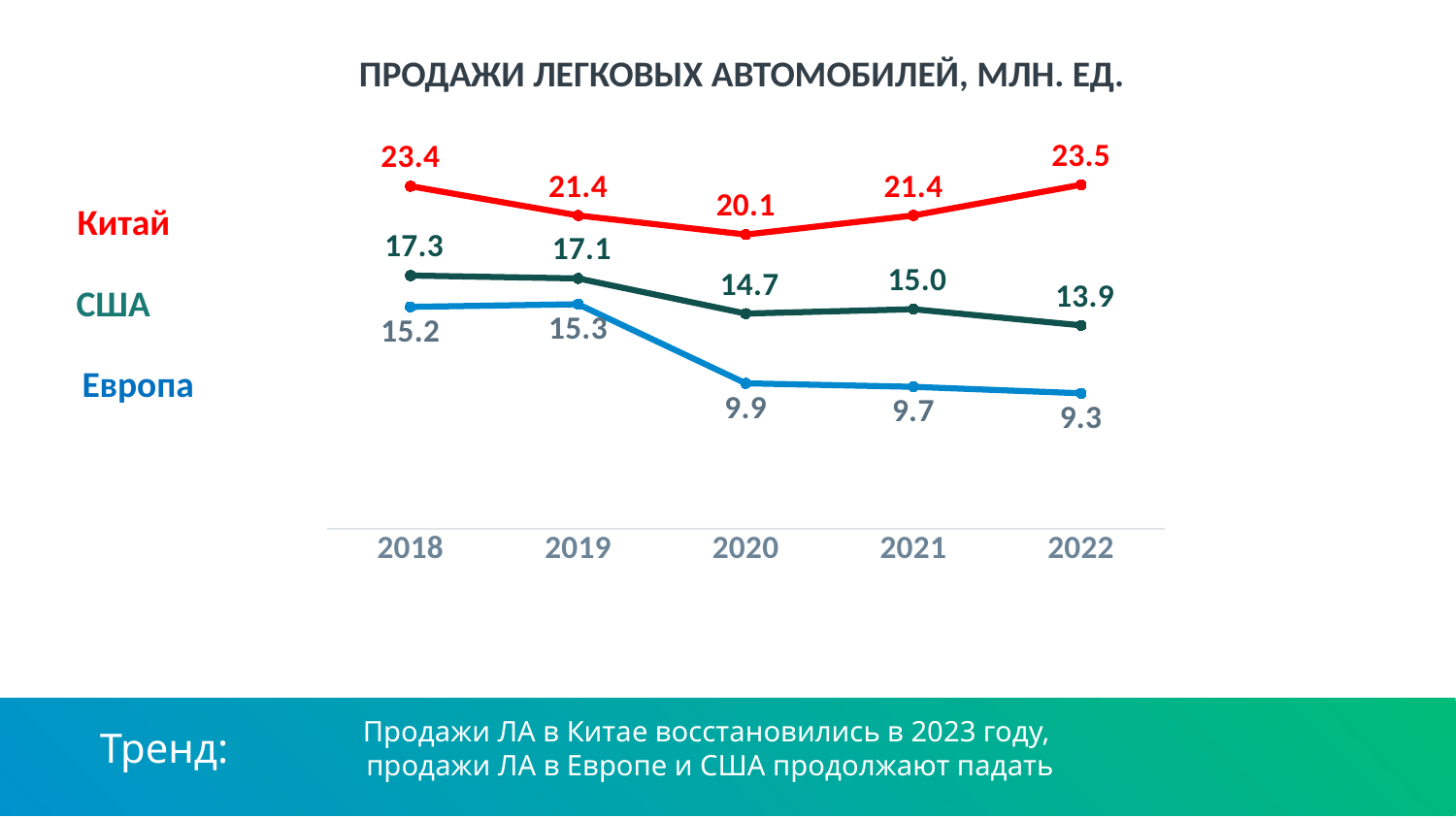
In which year was the value for Европа (Europe) the lowest? 2022 What is the title of the chart? ПРОДАЖИ ЛЕГКОВЫХ АВТОМОБИЛЕЙ, МЛН. ЕД. What was the value for США (USA) in 2022? 13.9 What was the value for Европа (Europe) in 2019? 15.3 What was the value for Китай (China) in 2020? 20.1 Does the value for Европа (Europe) rise or fall from 2019 to 2022? Fall What is the difference between the Китай (China) value and the США (USA) value in 2022? 9.6 What kind of chart is shown on the slide? Line chart Which series had the larger value in 2018: США (USA) or Европа (Europe)? США How many series does the chart show? 3 How many years are shown on the x axis? 5 In which year was the value for Китай (China) the highest? 2022